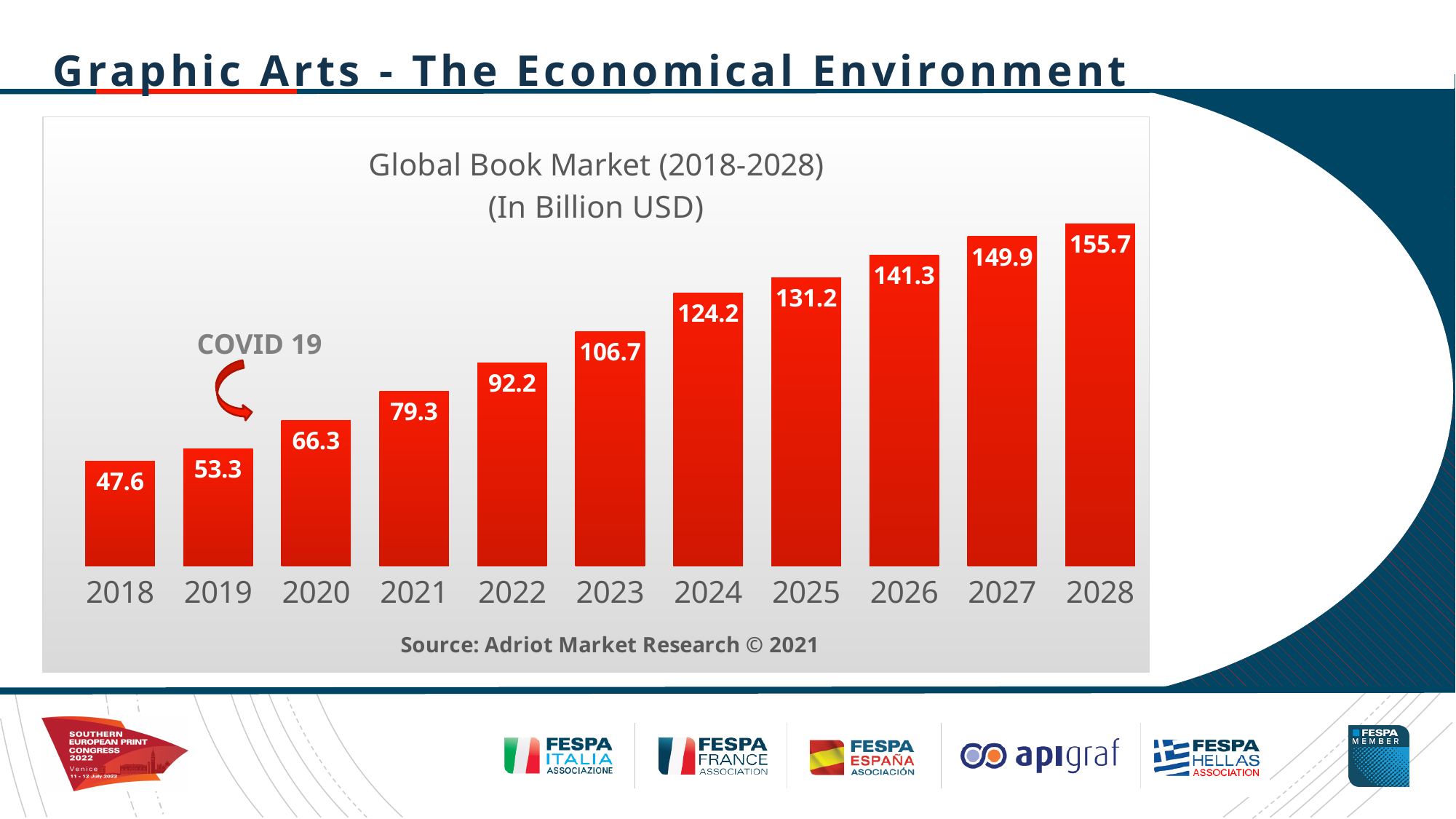
Do the values rise or fall from 2018 to 2028? Rise What kind of chart is shown on the slide? Bar chart What is the value for 2021 in the Global Book Market chart? 79.3 Which year has the highest value in the Global Book Market chart? 2028 What is the value for 2024 in the Global Book Market chart? 124.2 What is the difference between the values for 2020 and 2019? 13.0 What unit are the values in the Global Book Market chart expressed in? Billion USD How many years are shown in the Global Book Market chart? 11 What is the value for 2018 in the Global Book Market chart? 47.6 What is the difference between the values for 2028 and 2018? 108.1 Which year has the lowest value in the Global Book Market chart? 2018 Which is larger, the value for 2023 or the value for 2022? 2023